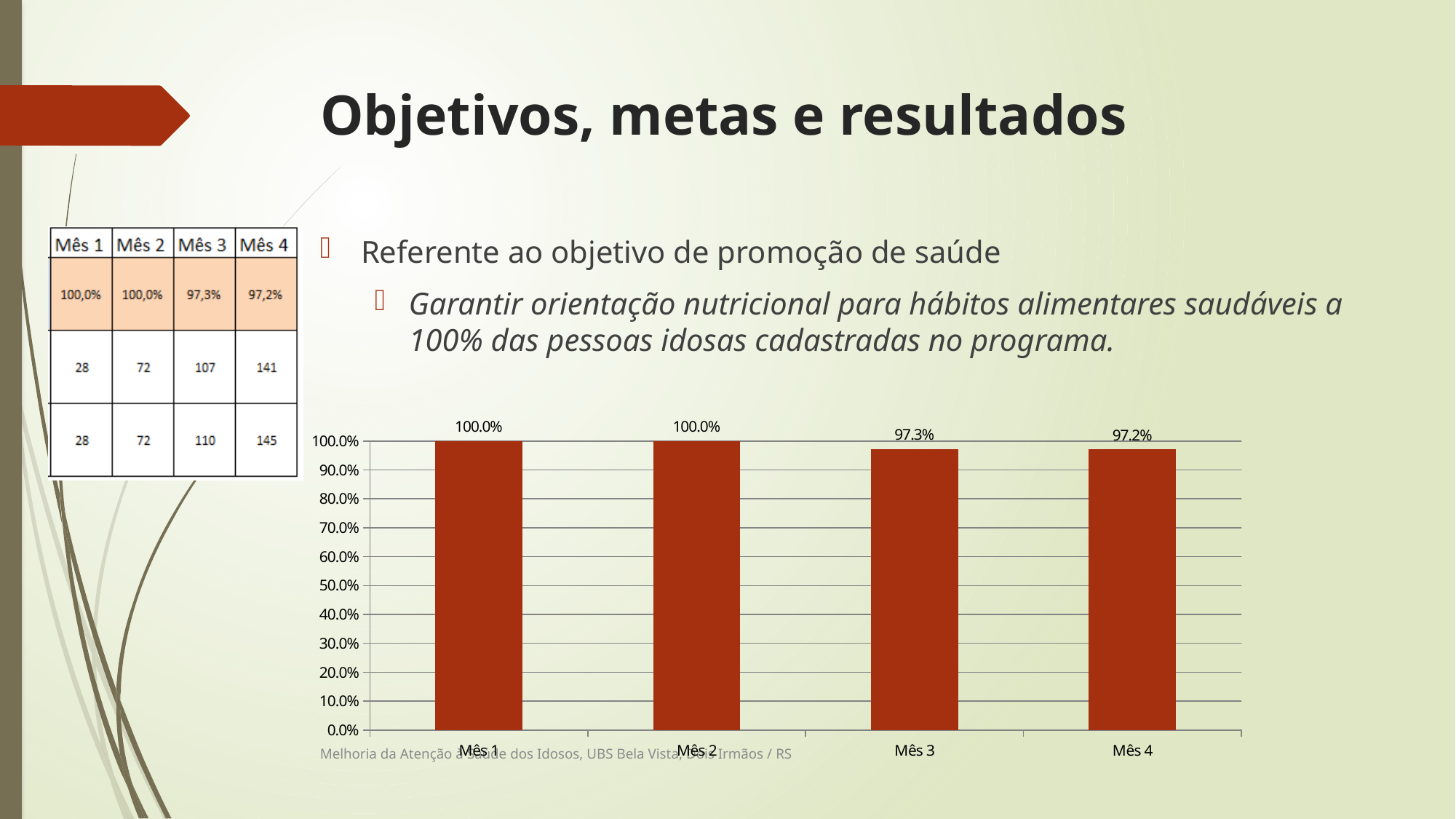
What is the value for Mês 2? 100.0% Do the values rise or fall from Mês 1 to Mês 4? fall What is the value for Mês 4? 97.2% What is the difference between the values for Mês 1 and Mês 3? 2.7% Which is larger, the value for Mês 1 or the value for Mês 3? Mês 1 Is the value for Mês 4 greater or less than 90.0%? greater How many categories are shown on the x axis of the chart? 4 What is the difference between the values for Mês 2 and Mês 4? 2.8% What is the value for Mês 1? 100.0% What kind of chart is shown on the slide? bar chart What is the value for Mês 3? 97.3% What is the highest tick value shown on the y axis of the chart? 100.0%